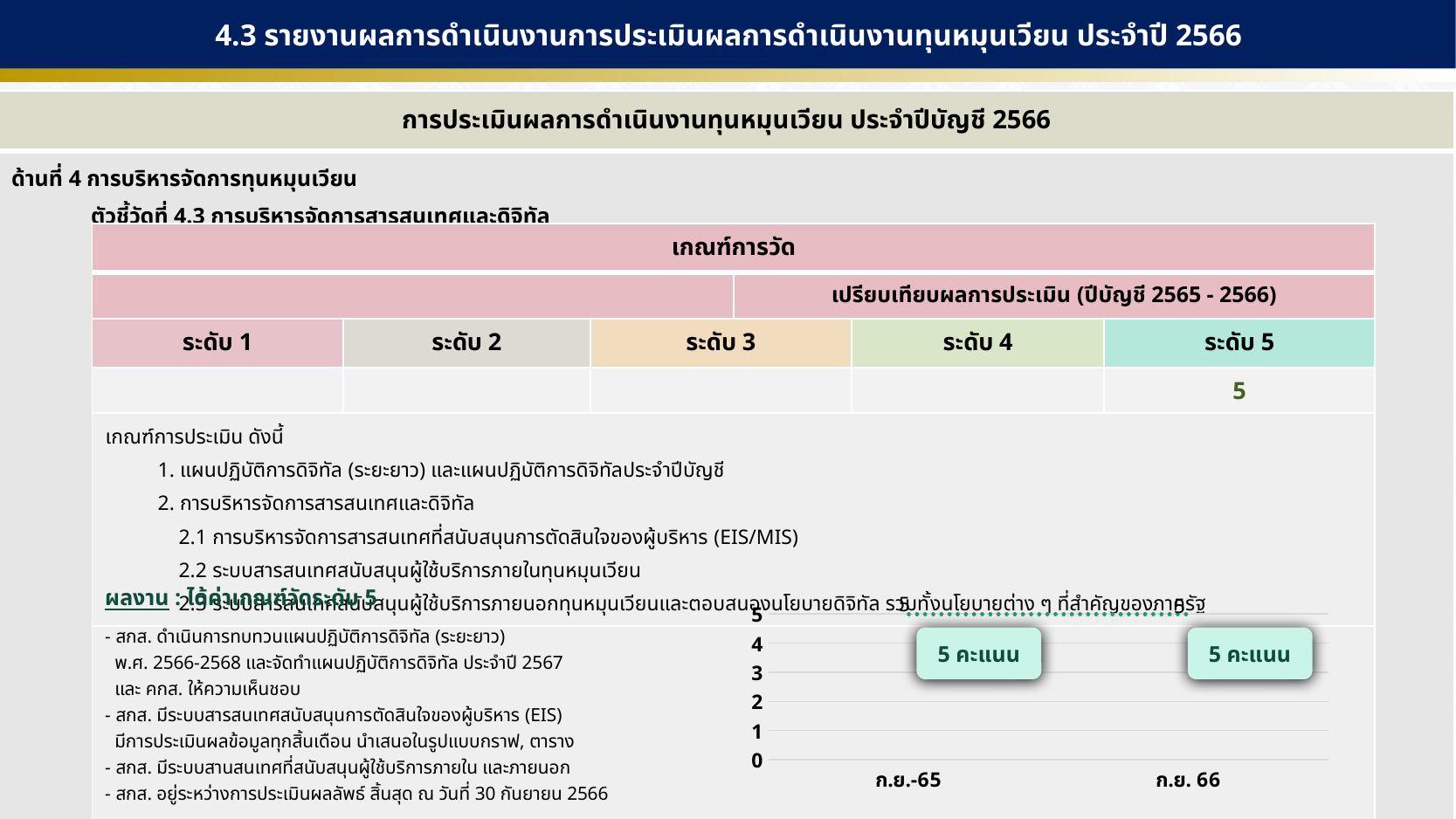
What kind of chart is shown at the bottom right of the slide? line chart What is the highest value shown on the y axis of the chart at the bottom right? 5 What is the difference between the values for ก.ย.-65 and ก.ย. 66 in the chart at the bottom right? 0 What are the two category labels on the x axis of the chart at the bottom right? ก.ย.-65 and ก.ย. 66 Is the value for ก.ย. 66 in the chart at the bottom right greater or less than 3? greater What value is shown for ก.ย. 66 in the chart at the bottom right of the slide? 5 คะแนน Is the value for ก.ย.-65 in the chart at the bottom right greater or less than 2? greater How many data points are plotted in the chart at the bottom right of the slide? 2 What value is shown for ก.ย.-65 in the chart at the bottom right of the slide? 5 คะแนน Does the value rise, fall or stay the same from ก.ย.-65 to ก.ย. 66 in the chart at the bottom right? stays the same